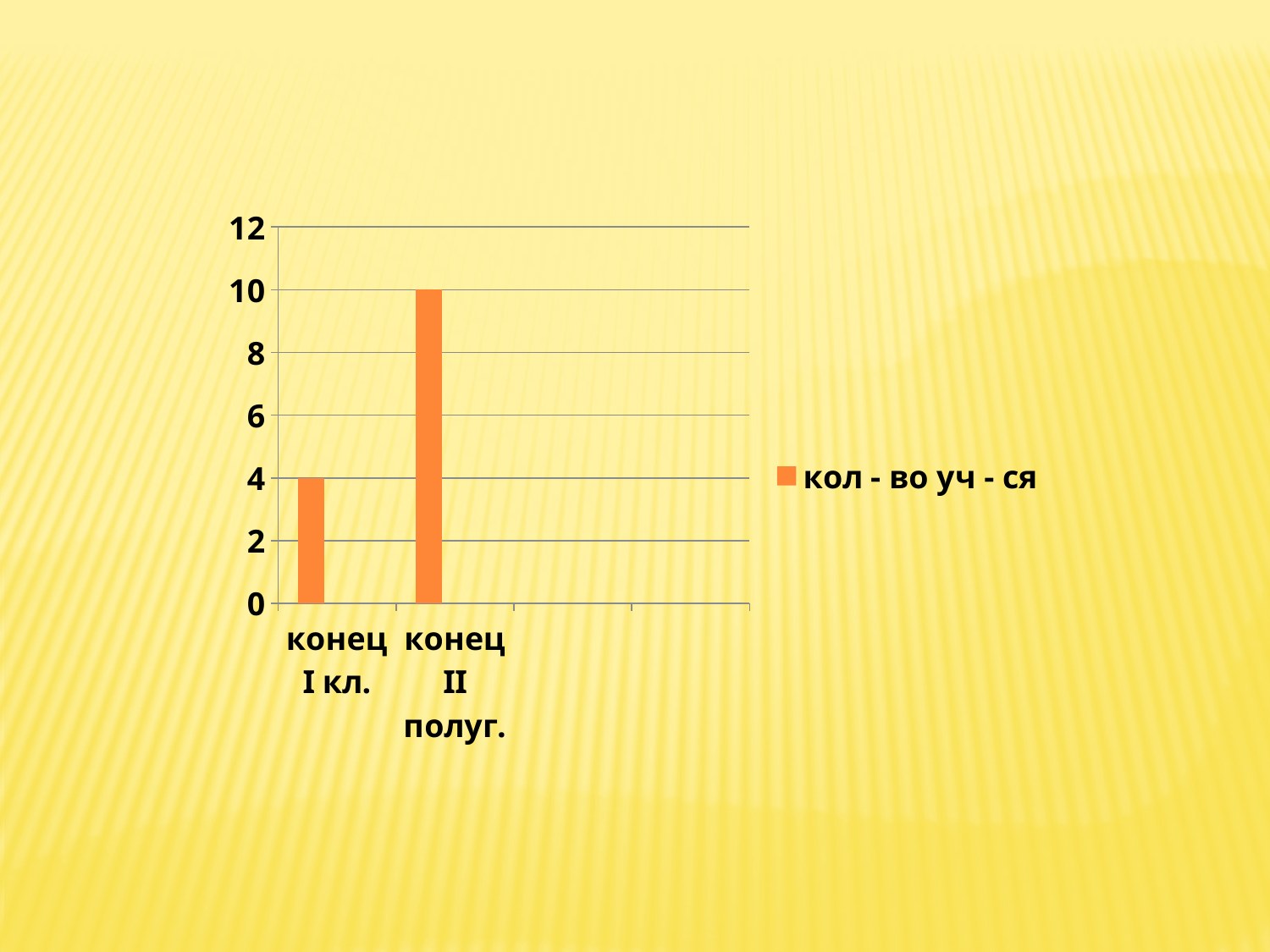
Is the value for "конец II полуг." greater or less than 8? greater Which is larger, the value for "конец I кл." or the value for "конец II полуг."? конец II полуг. Is the value for "конец I кл." greater or less than 6? less What is the difference between the values for "конец II полуг." and "конец I кл."? 6 What kind of chart is shown on the slide? bar chart Which category has the lowest value? конец I кл. Do the values rise or fall from "конец I кл." to "конец II полуг."? rise What is the value for "конец II полуг."? 10 How many categories are plotted on the chart? 2 How many series does the legend list? 1 Which category has the highest value? конец II полуг. What is the value for "конец I кл."? 4